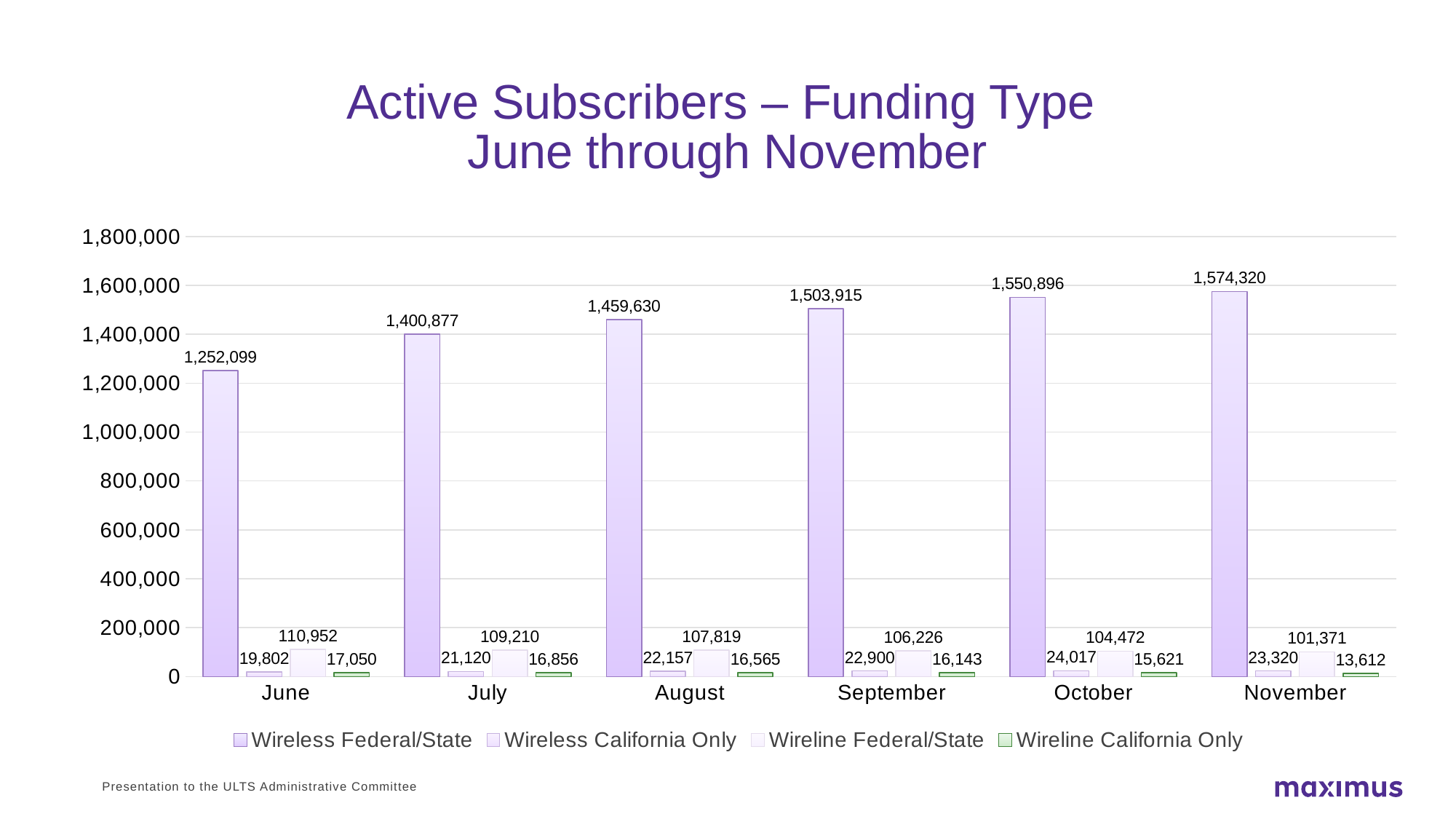
What is the value for Wireline California Only in November? 13,612 Is the value for Wireless Federal/State in July greater or less than 1,200,000? greater Which is larger in August: Wireless California Only or Wireline California Only? Wireless California Only What is the value for Wireline Federal/State in September? 106,226 What is the value for Wireless Federal/State in June? 1,252,099 What is the difference between the Wireless Federal/State values for November and June? 322,221 In which month is Wireless Federal/State highest? November Does the Wireline Federal/State series rise or fall from June to November? fall What is the value for Wireless California Only in October? 24,017 How many months are shown on the x axis? 6 In which month is Wireline Federal/State lowest? November How many series does the legend list? 4